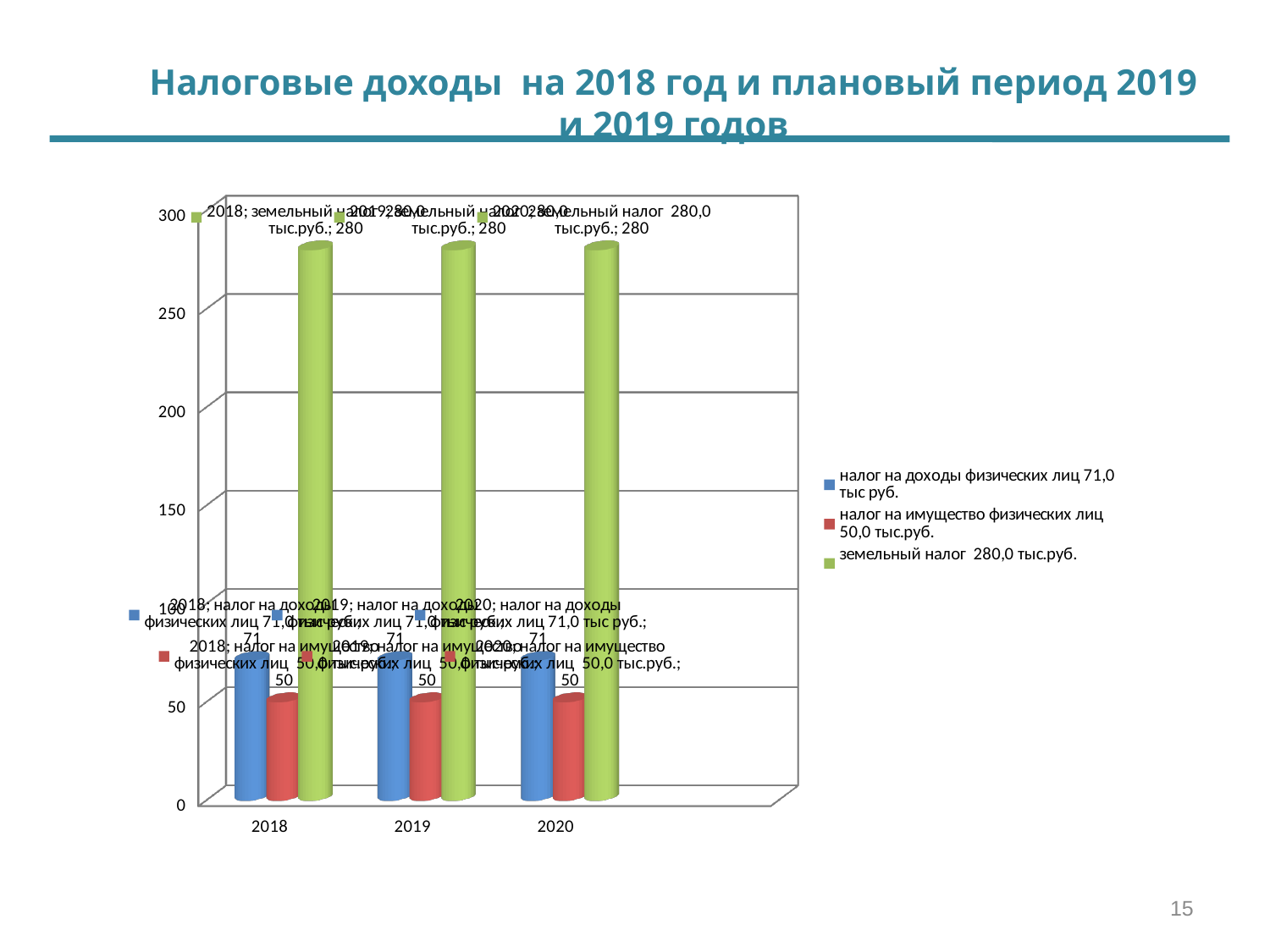
What is the value of налог на доходы физических лиц for 2019? 71 Which series has the highest value in 2020? земельный налог What is the value of налог на имущество физических лиц for 2020? 50 Which series has the lowest value in 2018? налог на имущество физических лиц Which is larger in 2018: налог на доходы физических лиц or налог на имущество физических лиц? налог на доходы физических лиц How many series does the legend list? 3 What is the difference between земельный налог and налог на доходы физических лиц in 2019? 209 Does the value of земельный налог change from 2018 to 2020? No, it stays at 280 How many years are shown on the x axis? 3 What type of chart is shown on the slide? bar chart What colour are the bars for земельный налог? green What is the value of земельный налог for 2018? 280